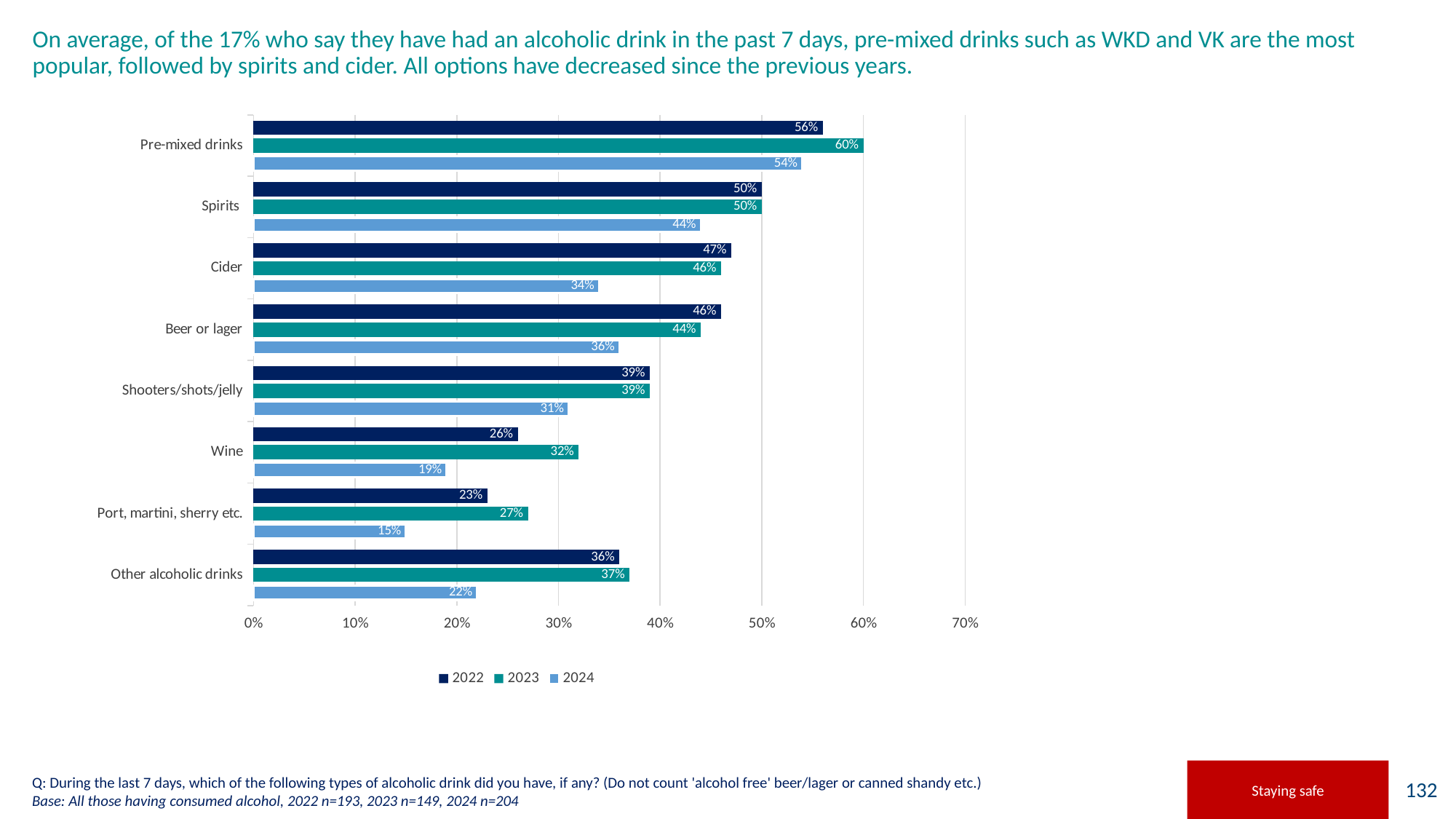
What is the value for Cider in 2023? 46% Which years are listed in the legend? 2022, 2023, 2024 Which category has the lowest value in 2022? Port, martini, sherry etc. How many series does the legend list? 3 What is the value for Port, martini, sherry etc. in 2024? 15% Which category has the highest value in 2024? Pre-mixed drinks What is the value for Pre-mixed drinks in 2024? 54% Which is larger for Wine: the 2022 value or the 2023 value? 2023 Is the 2024 value for Beer or lager greater or less than 40%? less What kind of chart is shown on the slide? Bar chart What is the difference between the 2023 and 2024 values for Cider? 12% How many drink categories are shown on the chart? 8